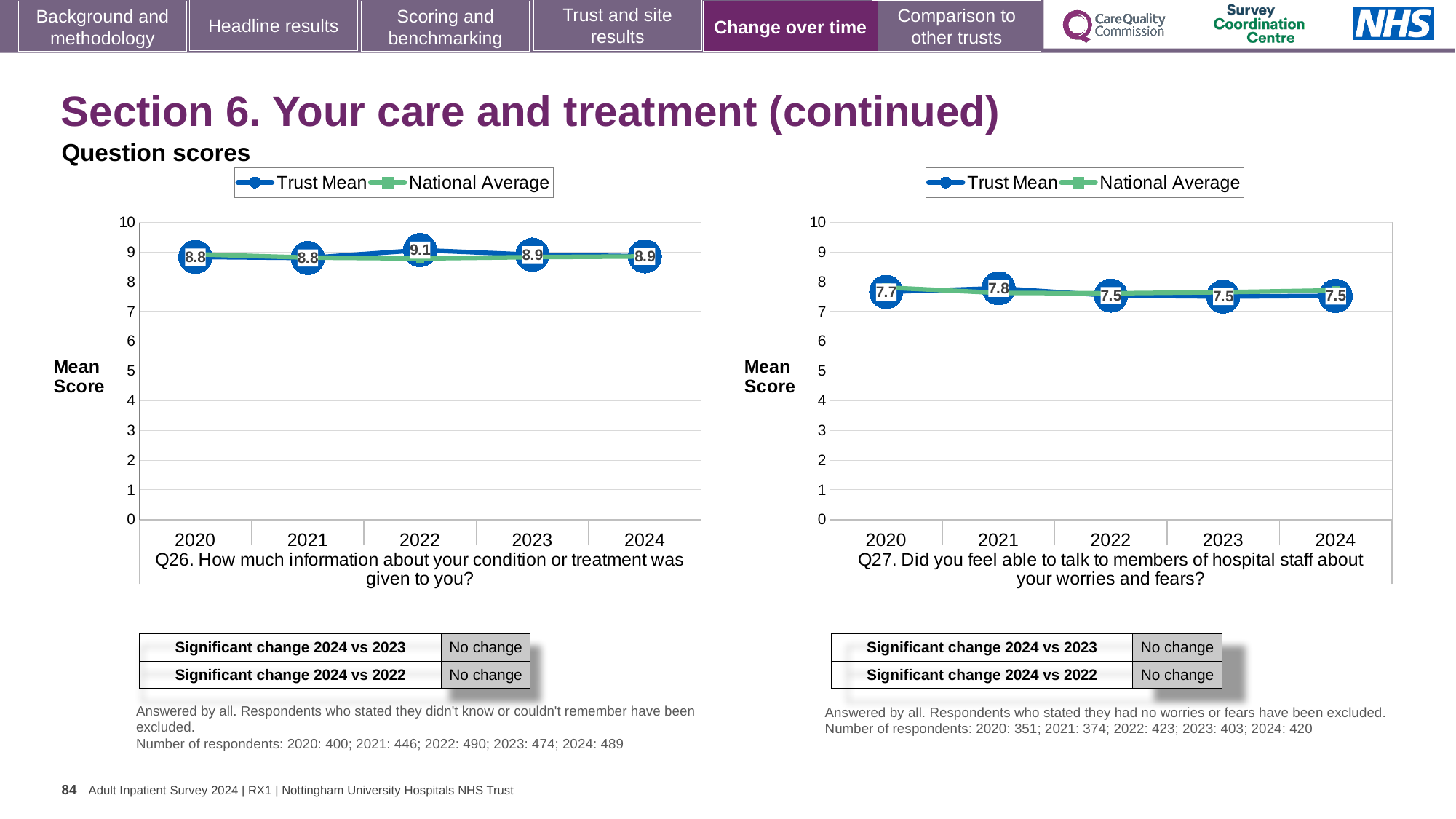
On the Q27 chart, how many years are plotted on the x axis? 5 On the Q26 chart, is the National Average value for 2024 greater or less than 8? greater On the Q27 chart, which year has the highest Trust Mean score? 2021 On the Q27 chart, does the Trust Mean score rise or fall from 2020 to 2024? Fall What kind of chart is the Q27 chart? Line chart On the Q27 chart, which year has the larger Trust Mean score, 2020 or 2022? 2020 On the Q26 chart, what is the difference between the Trust Mean scores for 2022 and 2020? 0.3 On the Q26 chart, what is the Trust Mean score for 2022? 9.1 On the Q27 chart, what is the difference between the Trust Mean scores for 2021 and 2024? 0.3 On the Q27 chart, what is the Trust Mean score for 2021? 7.8 On the Q26 chart, how many series does the legend list? 2 On the Q26 chart, which year has the highest Trust Mean score? 2022